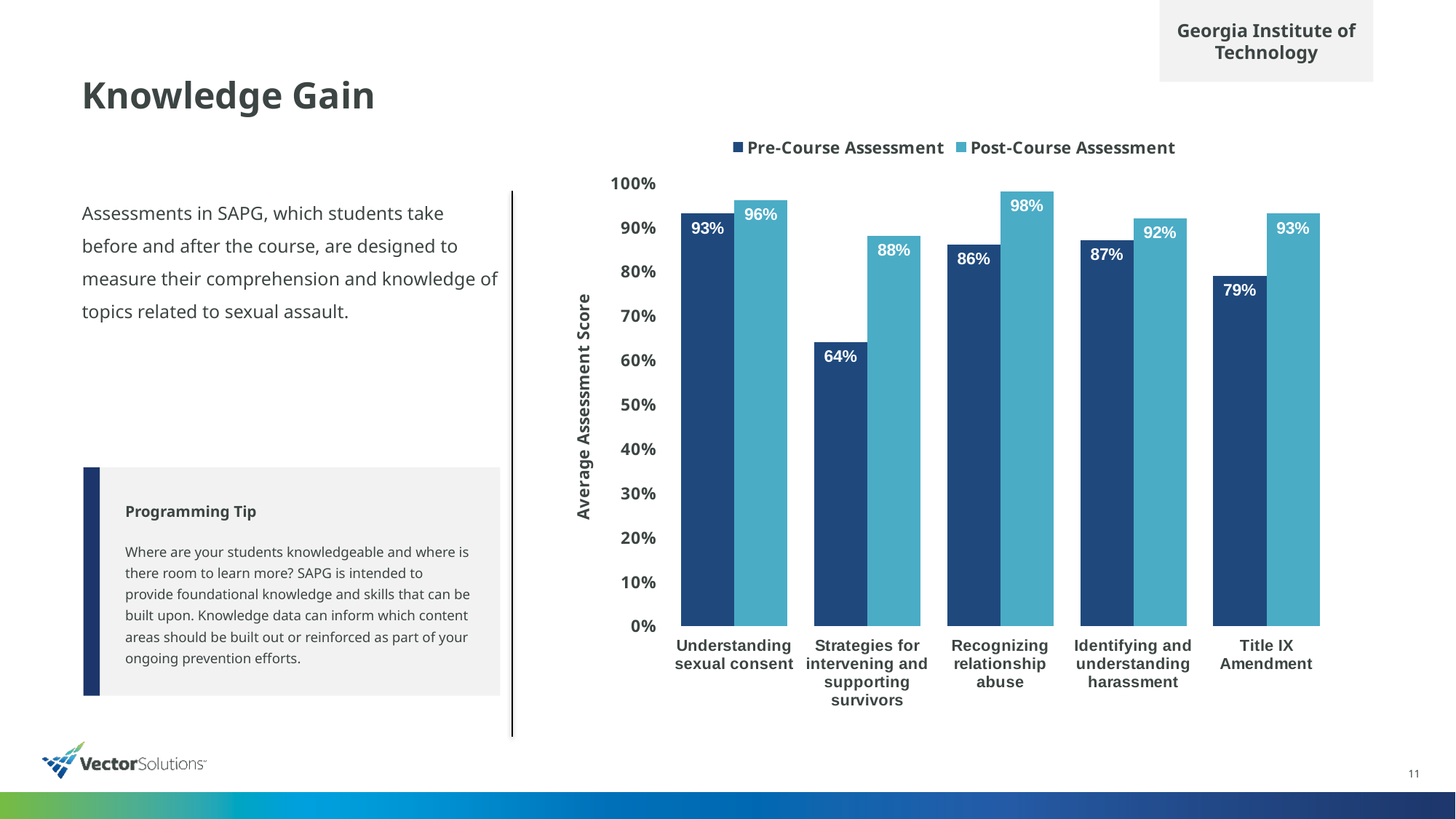
What kind of chart is shown on the slide? bar chart What is the Pre-Course Assessment value for Strategies for intervening and supporting survivors? 64% How many series does the legend list? 2 How many categories are shown on the x axis? 5 Which category has the highest Post-Course Assessment value? Recognizing relationship abuse Which is larger: the Pre-Course Assessment value for Understanding sexual consent or the Pre-Course Assessment value for Identifying and understanding harassment? Understanding sexual consent What is the difference between the Post-Course and Pre-Course Assessment values for Strategies for intervening and supporting survivors? 24% What is the Post-Course Assessment value for Recognizing relationship abuse? 98% What is the label of the vertical axis? Average Assessment Score Is the Pre-Course Assessment value for Title IX Amendment greater or less than 80%? less What is the Pre-Course Assessment value for Title IX Amendment? 79% Which category has the lowest Pre-Course Assessment value? Strategies for intervening and supporting survivors